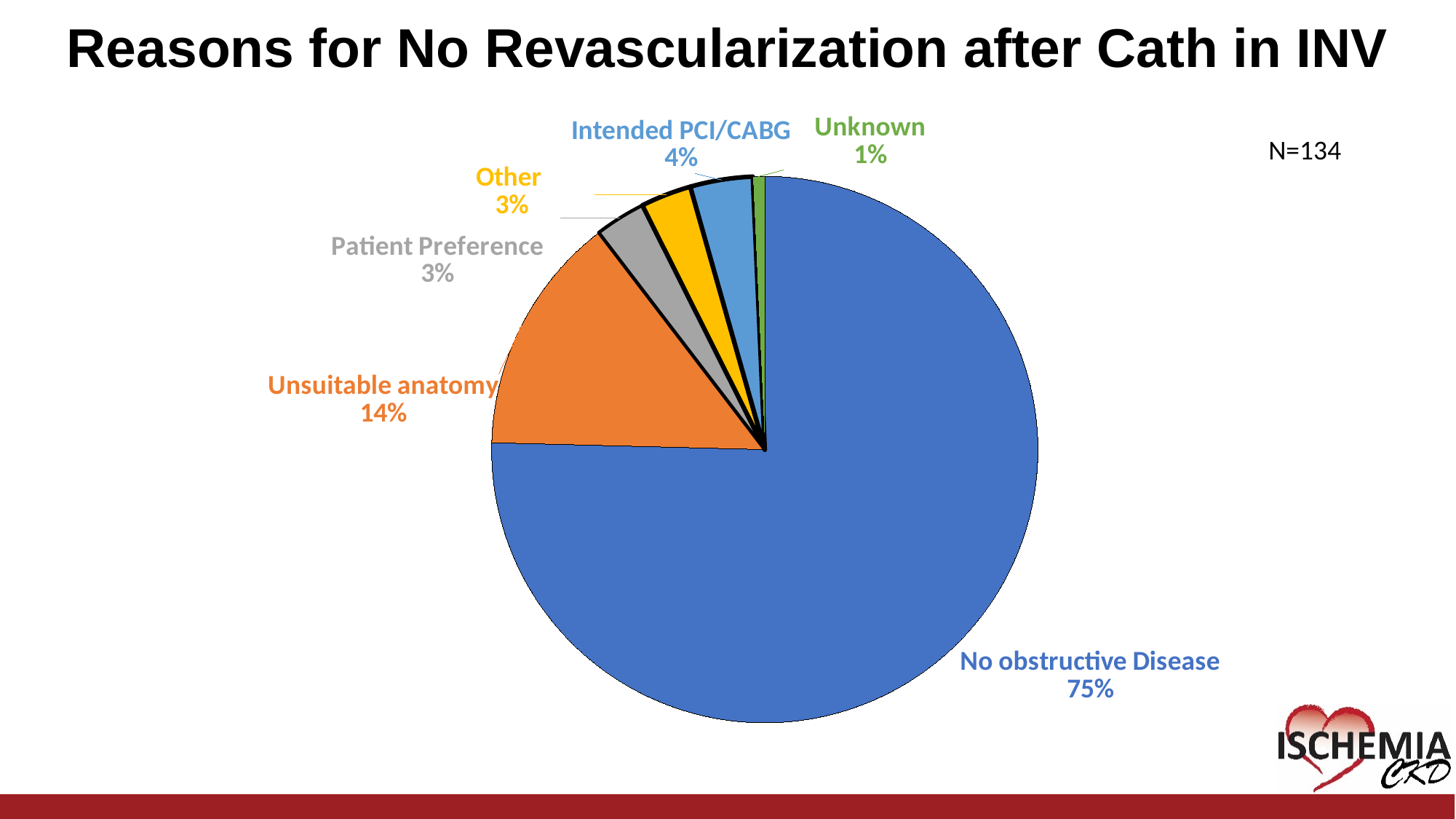
Which is larger, the share for Intended PCI/CABG or the share for Other? Intended PCI/CABG What share of the pie is Unsuitable anatomy? 14% What kind of chart is shown on the slide? Pie chart What is the N value shown on the slide? N=134 What is the difference in percentage points between No obstructive Disease and Unsuitable anatomy? 61 What share of the pie is No obstructive Disease? 75% How many categories are shown in the pie chart? 6 What share of the pie is Patient Preference? 3% Which category has the largest slice of the pie? No obstructive Disease Which category has the smallest slice of the pie? Unknown